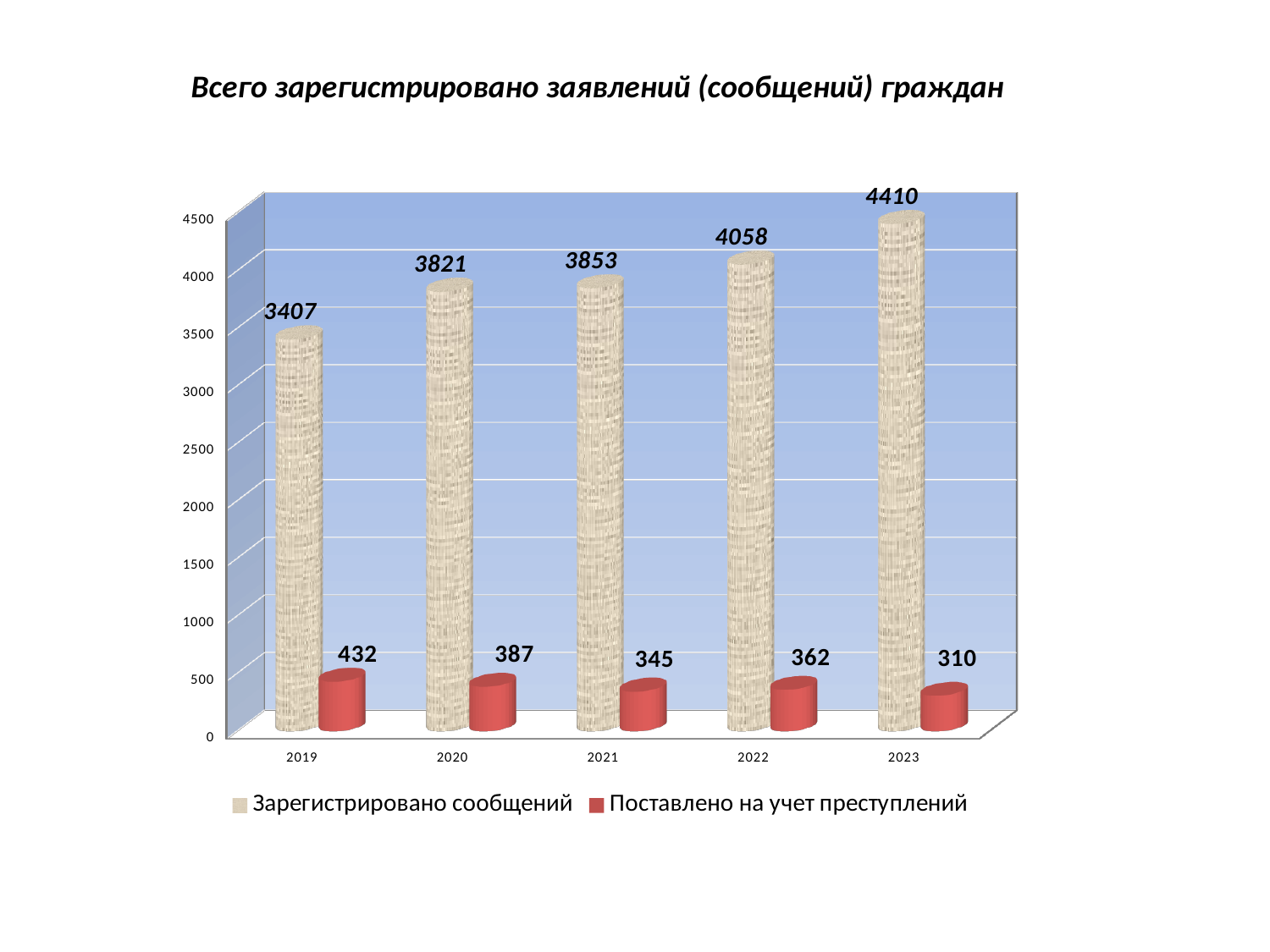
What is the value of "Поставлено на учет преступлений" for 2023? 310 What is the difference between the "Зарегистрировано сообщений" values for 2023 and 2019? 1003 Which is larger: "Поставлено на учет преступлений" in 2020 or in 2022? 2020 What is the value of "Зарегистрировано сообщений" for 2019? 3407 Which year has the lowest value for "Поставлено на учет преступлений"? 2023 Does the "Зарегистрировано сообщений" series rise or fall from 2019 to 2023? rise Is the value for "Зарегистрировано сообщений" in 2021 greater or less than 3500? greater Which year has the highest value for "Зарегистрировано сообщений"? 2023 What is the value of "Зарегистрировано сообщений" for 2022? 4058 How many series does the legend list? 2 How many years are shown on the x axis? 5 What kind of chart is shown on the slide? bar chart